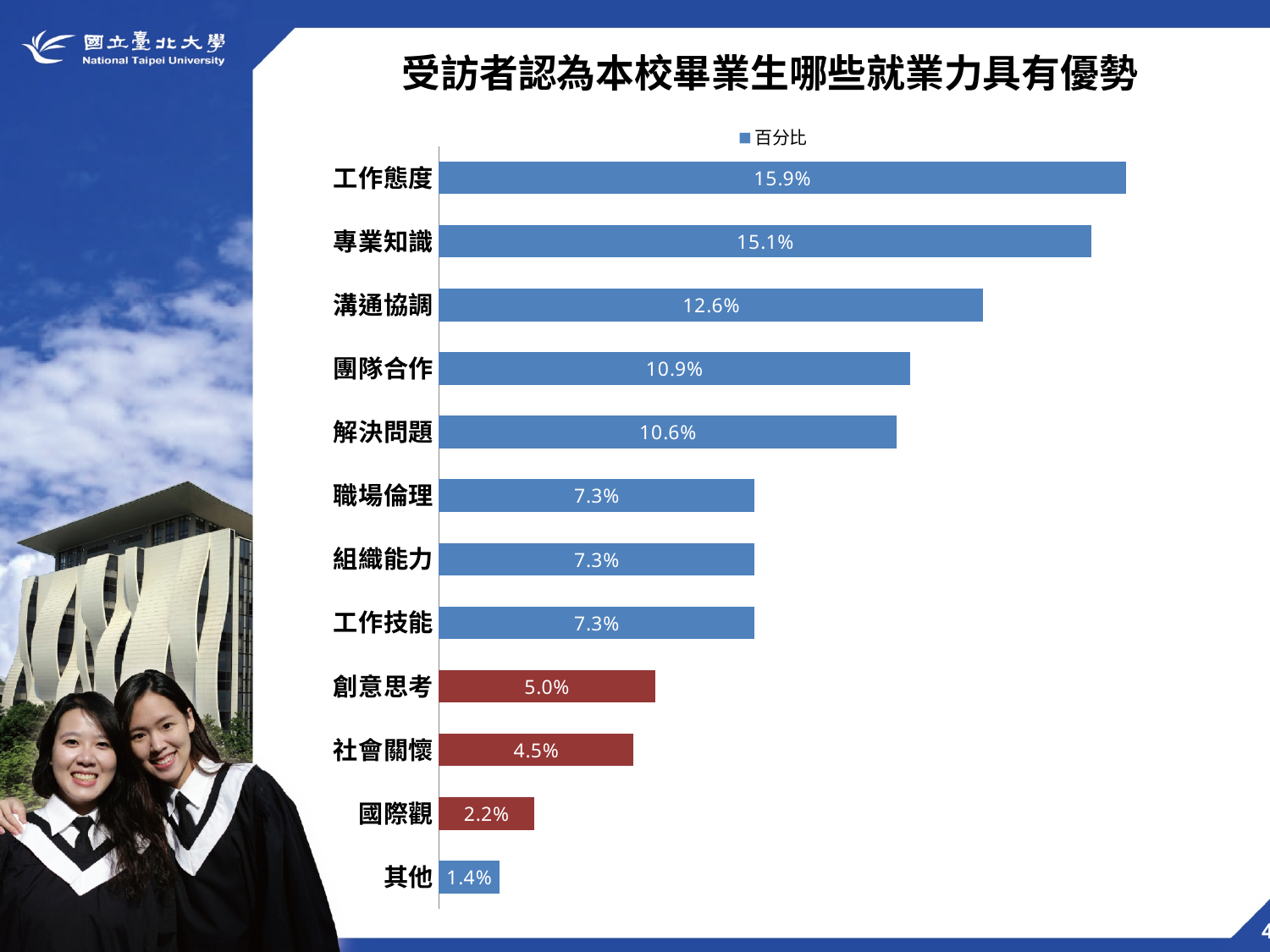
Which is larger, the value for 創意思考 or the value for 社會關懷? 創意思考 What is the value for 溝通協調? 12.6% What kind of chart is shown on the slide? bar chart Which category has the lowest value? 其他 What is the legend entry shown above the chart? 百分比 How many categories are shown in the chart? 12 What is the difference between the values for 團隊合作 and 解決問題? 0.3% What is the difference between the values for 工作態度 and 專業知識? 0.8% What is the value for 國際觀? 2.2% Which category has the highest value? 工作態度 How many series does the legend list? 1 What is the value for 工作態度? 15.9%